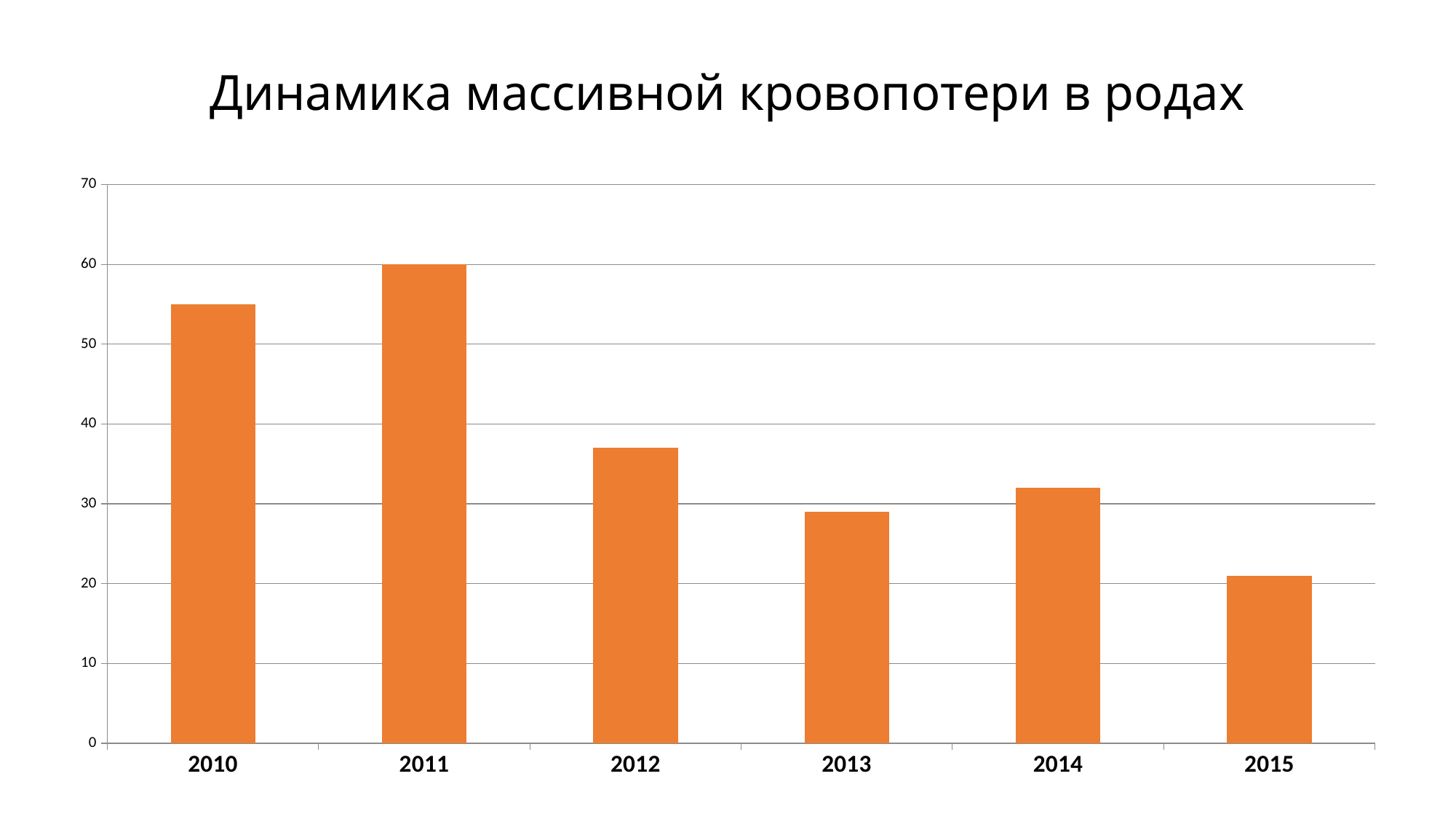
Is the value for 2012 greater or less than 40? less What is the title of the chart? Динамика массивной кровопотери в родах Is the value for 2010 greater or less than 50? greater What kind of chart is shown on the slide? bar chart Which is larger, the value for 2012 or the value for 2014? 2012 What is the value for 2011? 60 Which year has the lowest value? 2015 Is the value for 2014 greater or less than 30? greater Which year has the highest value? 2011 How many years are shown on the x axis? 6